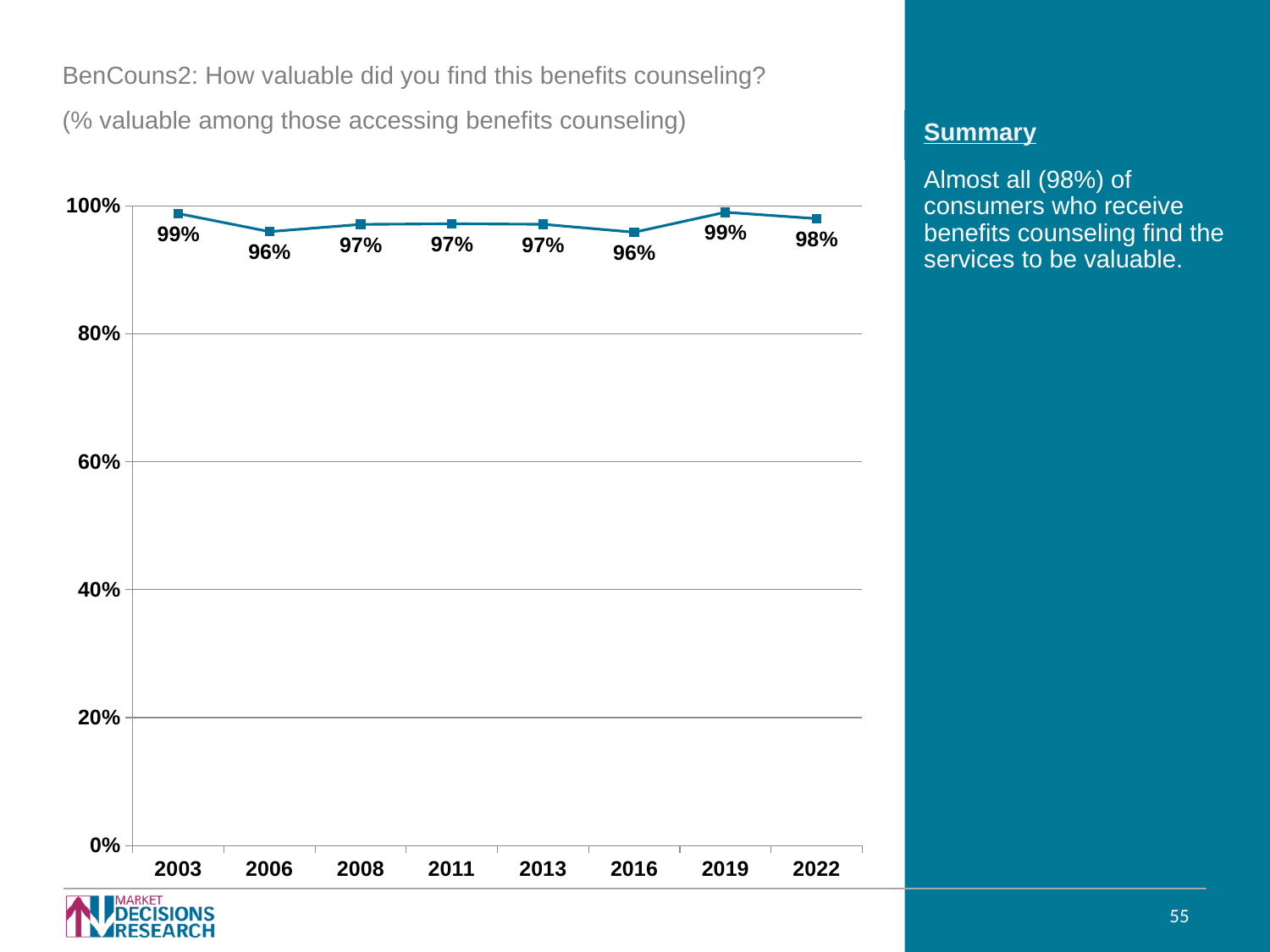
What is the difference between the 2019 value and the 2016 value? 3% Which years have the highest value on the chart? 2003 and 2019 What value is shown for 2016? 96% What kind of chart is shown on the slide? line chart What value is shown for 2003? 99% What is the survey question shown in the chart title? BenCouns2: How valuable did you find this benefits counseling? Did the value rise or fall from 2019 to 2022? fall Which years have the lowest value on the chart? 2006 and 2016 Is the value for 2006 larger or smaller than the value for 2022? smaller Is the value for 2011 greater or less than 80%? greater How many years are plotted on the chart? 8 What percentage of consumers found benefits counseling valuable in 2022? 98%